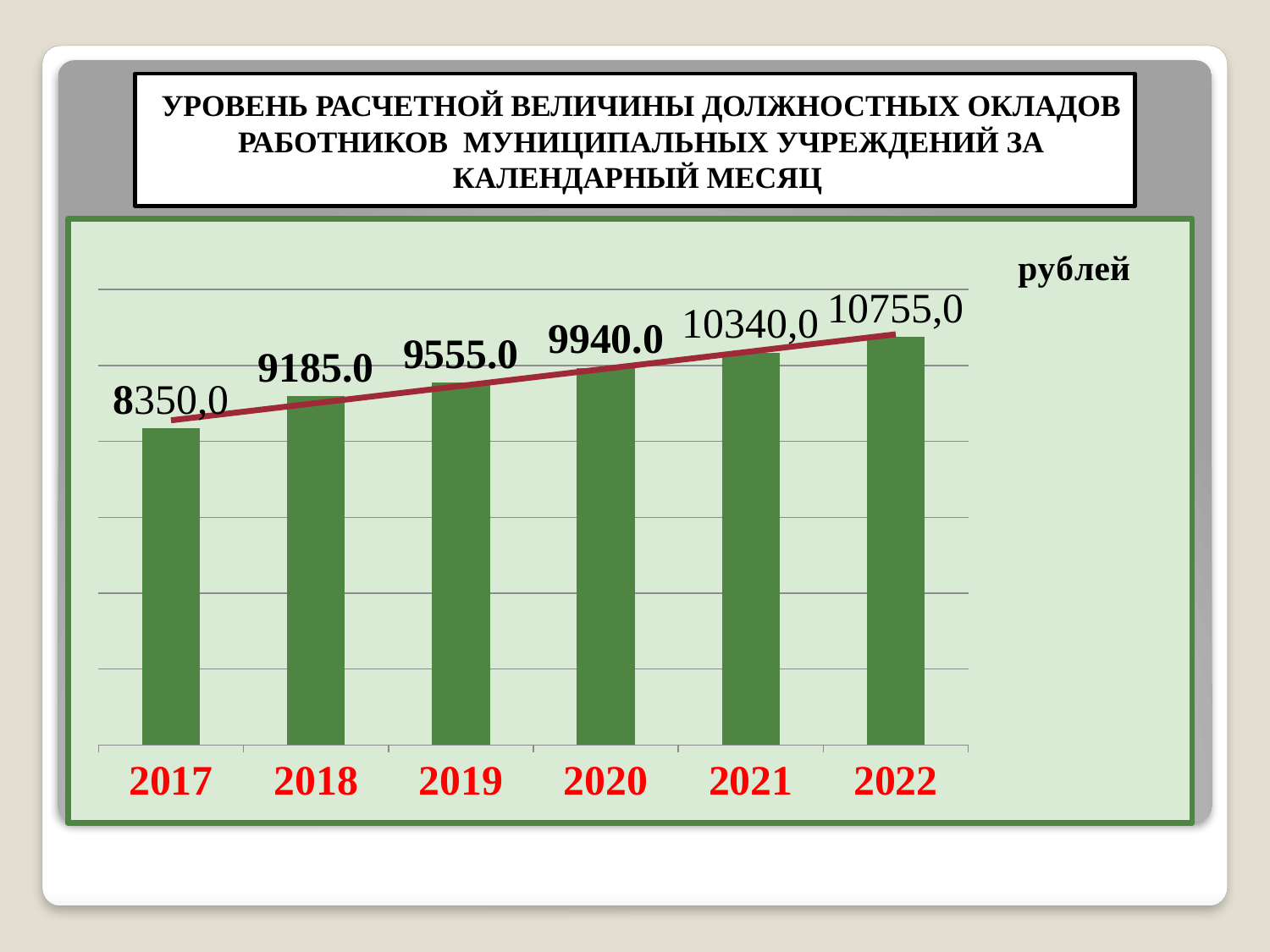
What is the value for 2021? 10340,0 Do the values rise or fall from 2017 to 2022? rise Which year has the highest value? 2022 How many years are shown on the x axis? 6 What is the value for 2022? 10755,0 What is the value for 2020? 9940.0 What is the value for 2017? 8350,0 What is the value for 2019? 9555.0 What is the value for 2018? 9185.0 Which year has the lowest value? 2017 What is the difference between the values for 2022 and 2017? 2405,0 Which is larger, the value for 2019 or the value for 2021? 2021